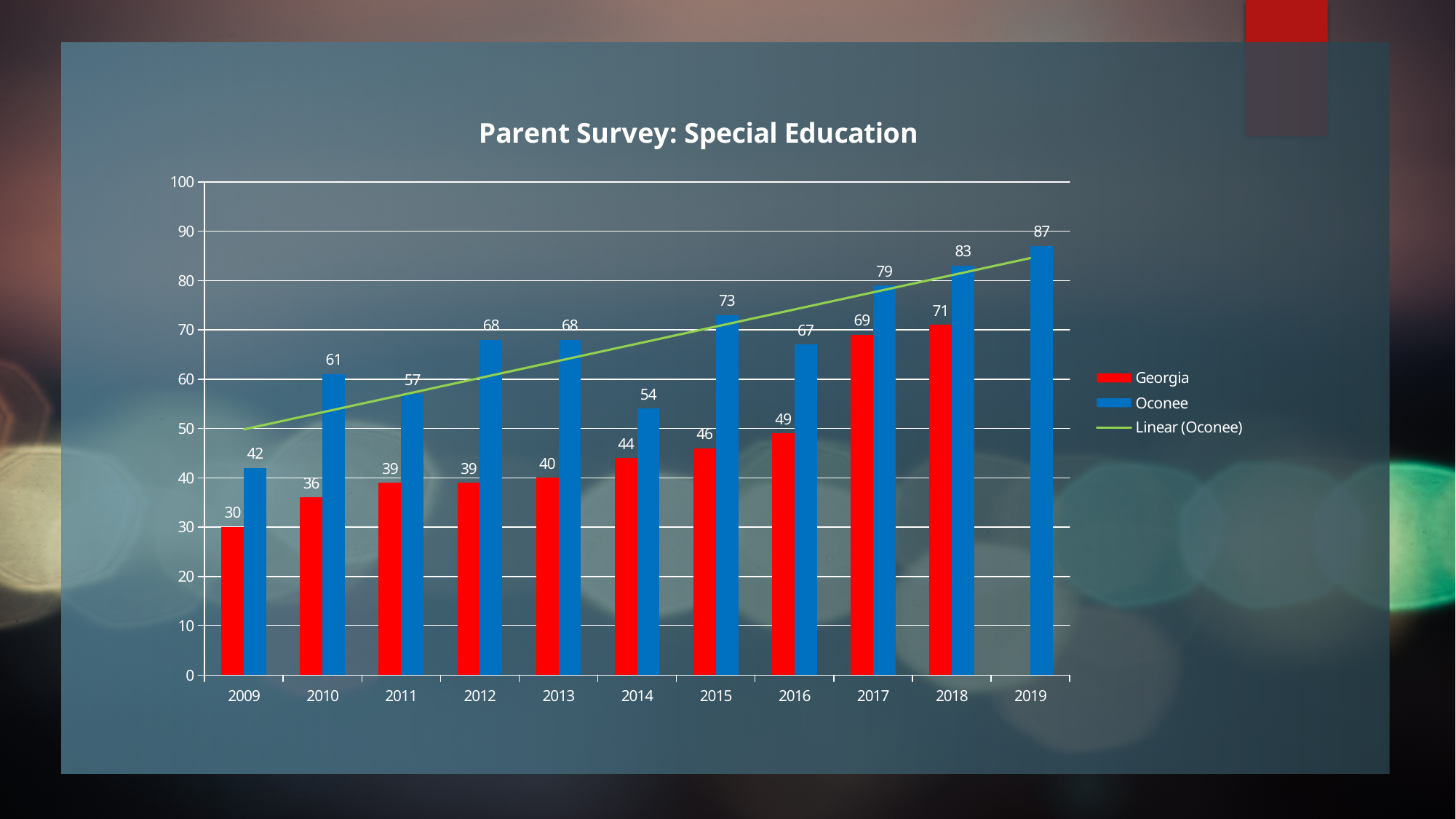
What is the title of the chart? Parent Survey: Special Education Do the Georgia values rise or fall from 2009 to 2018? rise What is the difference between the Oconee and Georgia values in 2010? 25 What is the Georgia value for 2013? 40 Which is larger in 2014, the Georgia value or the Oconee value? Oconee What kind of chart is this? bar chart How many entries does the legend list? 3 In which year is the Georgia value lowest? 2009 How many years are shown on the x axis? 11 Is the Oconee value for 2016 greater or less than 60? greater In which year is the Oconee value highest? 2019 What is the Oconee value for 2019? 87